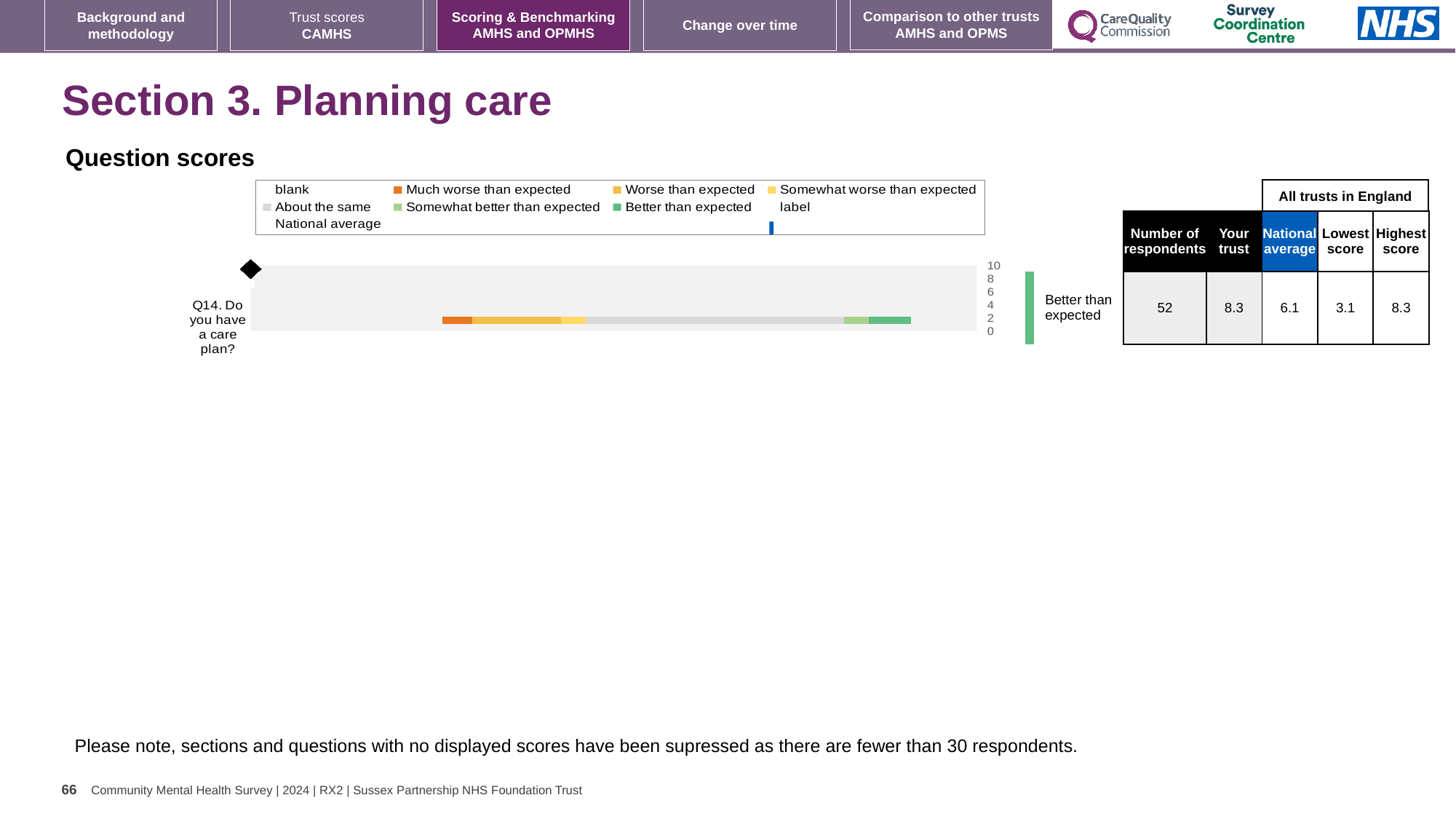
What is the national average score for Q14? 6.1 What is the 'Your trust' score for Q14? 8.3 What is the highest score among all trusts in England for Q14? 8.3 How many respondents answered Q14? 52 What benchmark category is shown next to the Q14 bar? Better than expected How many questions are plotted in the Question scores chart? 1 Which question is plotted in the Question scores chart? Q14. Do you have a care plan? What is the difference between the trust's score and the national average for Q14? 2.2 What kind of chart is shown under 'Question scores'? Bar chart Which is larger for Q14, the trust's score or the national average? Your trust What is the lowest score among all trusts in England for Q14? 3.1 What is the highest value shown on the score axis of the Question scores chart? 10